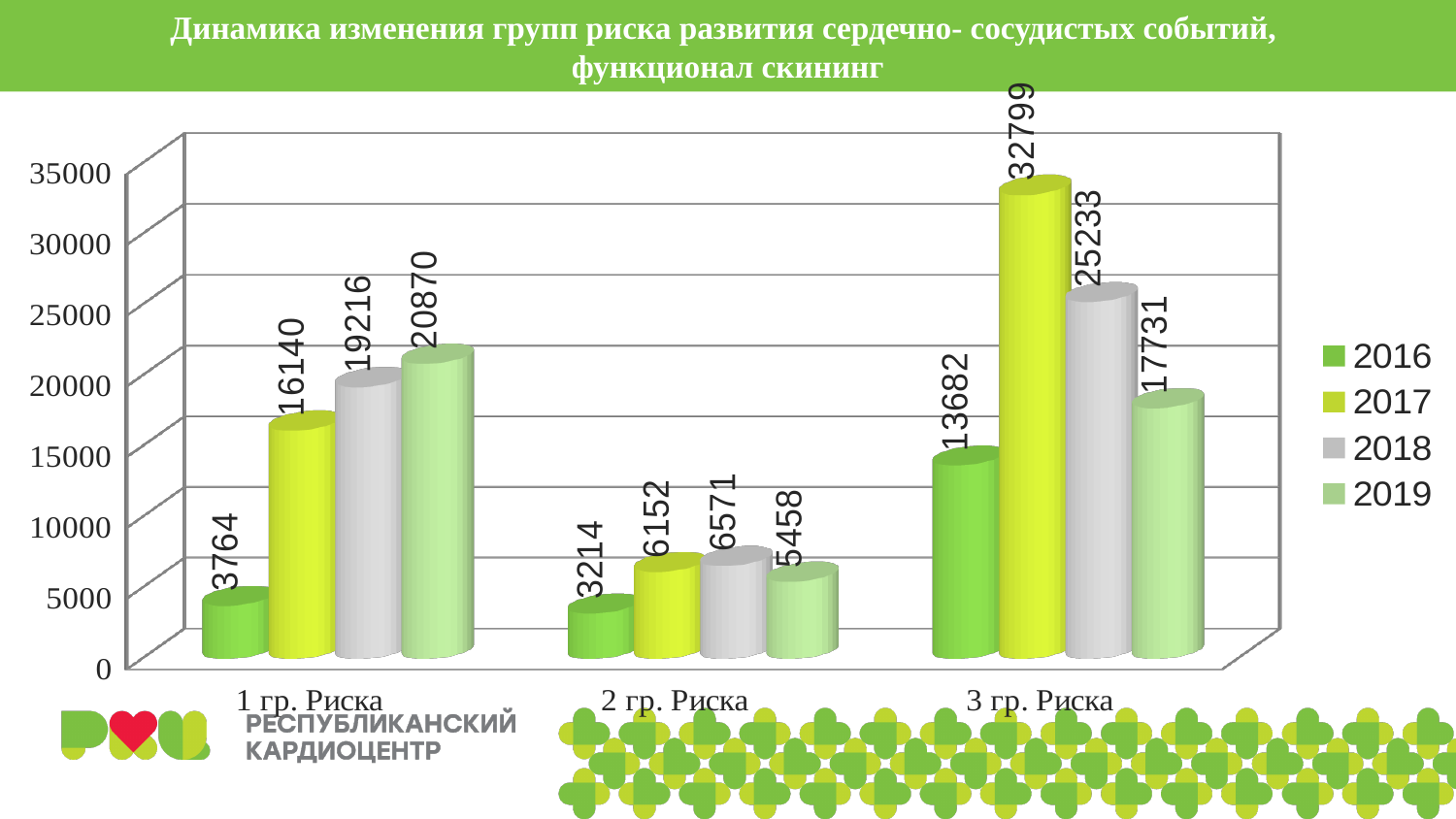
Which is larger: the 2018 value for "2 гр. Риска" or the 2019 value for "2 гр. Риска"? 2018 Which category has the lowest value for the 2018 series? 2 гр. Риска How many categories are shown on the x axis? 3 What is the difference between the 2017 and 2016 values in the "3 гр. Риска" category? 19117 How many series does the legend list? 4 What is the difference between the 2019 and 2018 values in the "1 гр. Риска" category? 1654 What is the value for 2019 in the "3 гр. Риска" category? 17731 Which category has the highest value for the 2017 series? 3 гр. Риска In the "1 гр. Риска" category, do the values rise or fall from 2016 to 2019? rise What kind of chart is shown on the slide? bar chart What is the value for 2016 in the "2 гр. Риска" category? 3214 What is the value for 2017 in the "1 гр. Риска" category? 16140